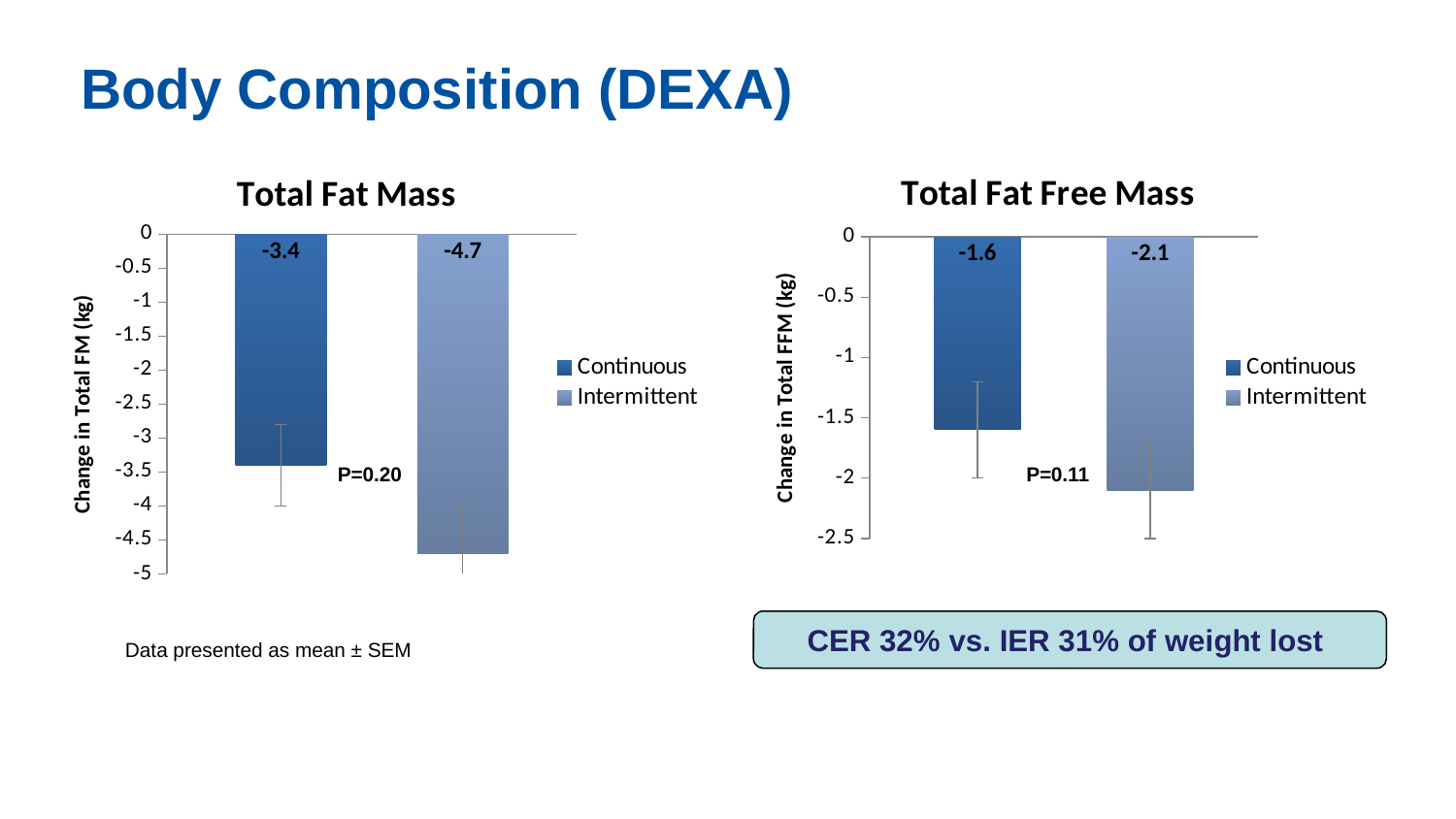
In the Total Fat Mass chart, which group has the lowest value (largest decrease)? Intermittent In the Total Fat Mass chart, what is the difference between the Continuous and Intermittent values? 1.3 How many series does the legend of the Total Fat Free Mass chart list? 2 In the Total Fat Mass chart, what is the value for Continuous? -3.4 In the Total Fat Free Mass chart, what is the difference between the Continuous and Intermittent values? 0.5 What kind of chart is the Total Fat Mass chart? Bar chart In the Total Fat Free Mass chart, which group has the lowest value (largest decrease)? Intermittent What is the y-axis label of the Total Fat Free Mass chart? Change in Total FFM (kg) In the Total Fat Mass chart, what is the value for Intermittent? -4.7 In the Total Fat Free Mass chart, what is the value for Intermittent? -2.1 In the Total Fat Mass chart, which bar extends further below zero, Continuous or Intermittent? Intermittent In the Total Fat Free Mass chart, what is the value for Continuous? -1.6